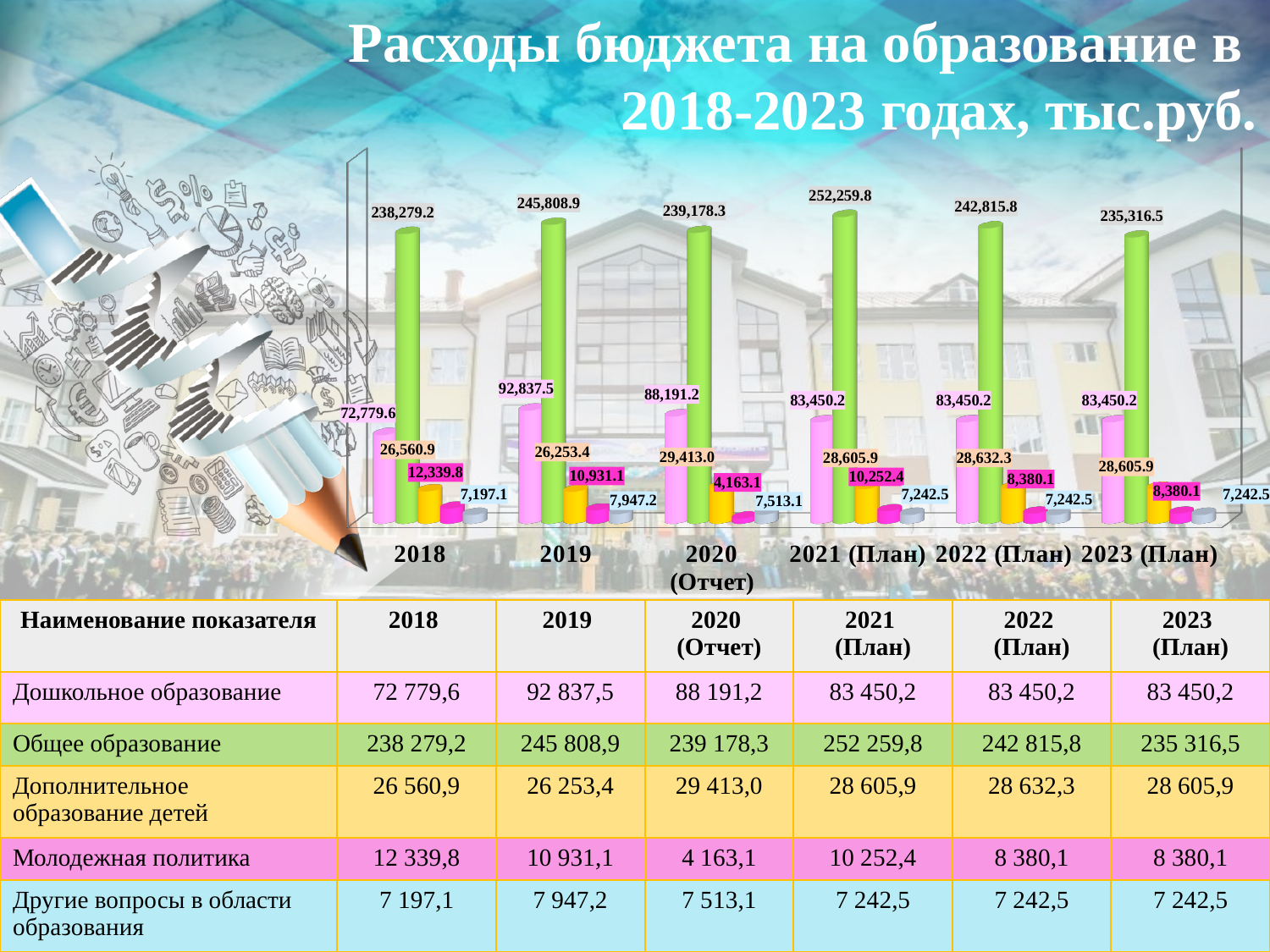
In which year is the green bar (Общее образование) the highest? 2021 (План) In which year is the green bar (Общее образование) the lowest? 2023 (План) What is the value of the magenta bar (Молодежная политика) for 2020 (Отчет)? 4,163.1 What is the difference between the green bar values for 2021 (План) and 2022 (План)? 9,444.0 Do the green bar values rise or fall from 2021 (План) to 2023 (План)? fall What is the value of the pink bar (Дошкольное образование) for 2020 (Отчет)? 88,191.2 What is the title of the chart on the slide? Расходы бюджета на образование в 2018-2023 годах, тыс.руб. Which year has the larger pink bar (Дошкольное образование): 2019 or 2020 (Отчет)? 2019 What is the value of the tallest (green) bar for 2019 in the chart? 245,808.9 In which year is the magenta bar (Молодежная политика) the lowest? 2020 (Отчет) What kind of chart is shown on the slide? bar chart How many year categories are shown along the x axis of the chart? 6